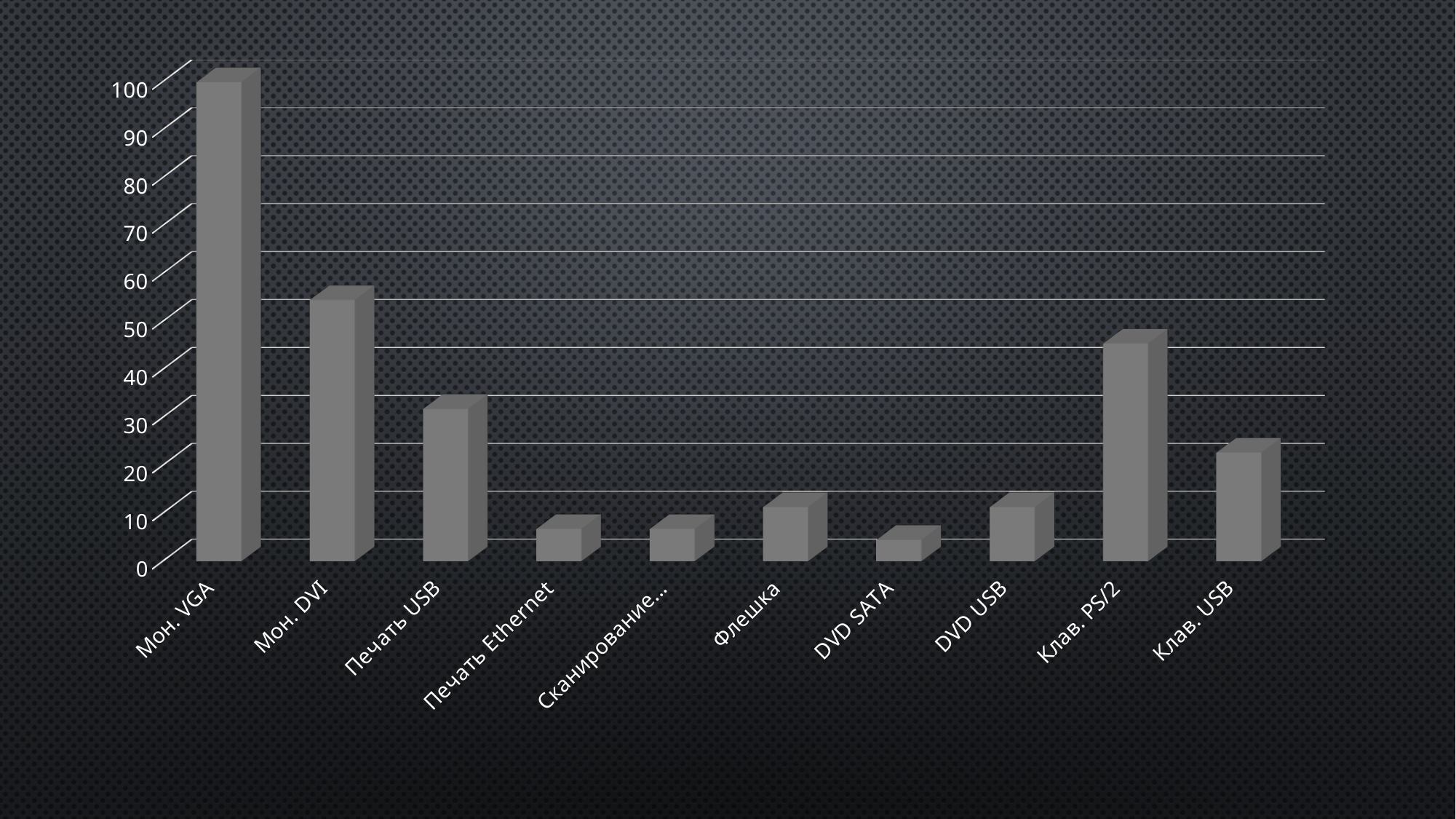
Is the value for Клав. USB greater or less than 20? greater Which is larger, the value for Мон. DVI or the value for Клав. PS/2? Мон. DVI How many categories are plotted on the chart? 10 What kind of chart is shown on the slide? bar chart Which category has the highest bar? Мон. VGA Is the value for Мон. DVI greater or less than 50? greater Is the value for Клав. PS/2 greater or less than 50? less Which category has the lowest bar? DVD SATA Which is larger, the value for Печать USB or the value for Клав. USB? Печать USB What is the label of the first category on the x axis? Мон. VGA